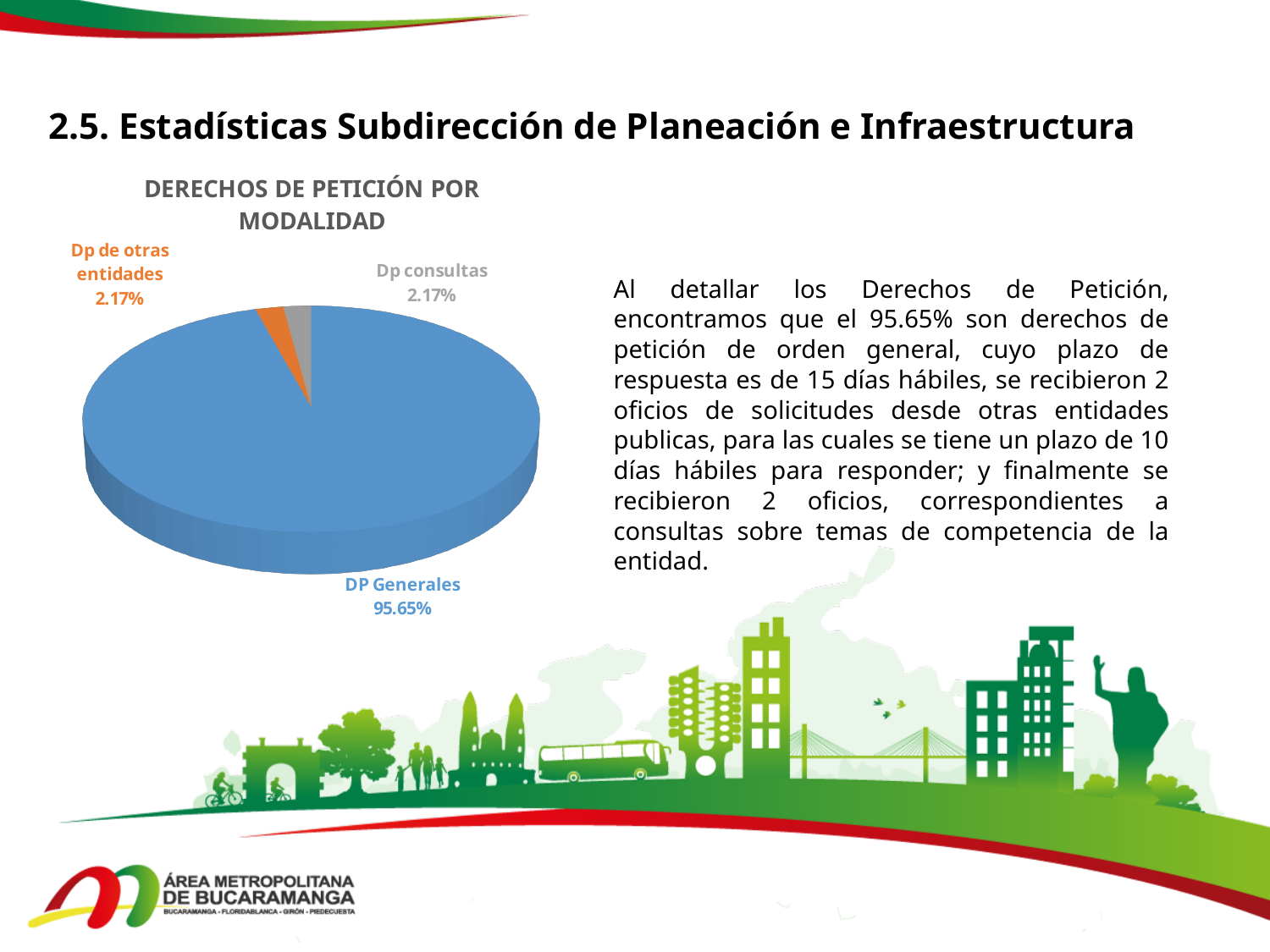
What is the value shown for Dp de otras entidades? 2.17% What colour is the DP Generales slice? Blue What type of chart is shown on the slide? Pie chart Which category has the largest slice of the pie? DP Generales What is the title of the chart? DERECHOS DE PETICIÓN POR MODALIDAD What is the difference between the share of DP Generales and the share of Dp consultas? 93.48% How many categories are shown in the pie chart? 3 What is the value shown for Dp consultas? 2.17% Which is larger, the share of DP Generales or the share of Dp de otras entidades? DP Generales What is the combined share of Dp consultas and Dp de otras entidades? 4.34% What share of the pie does DP Generales represent? 95.65%